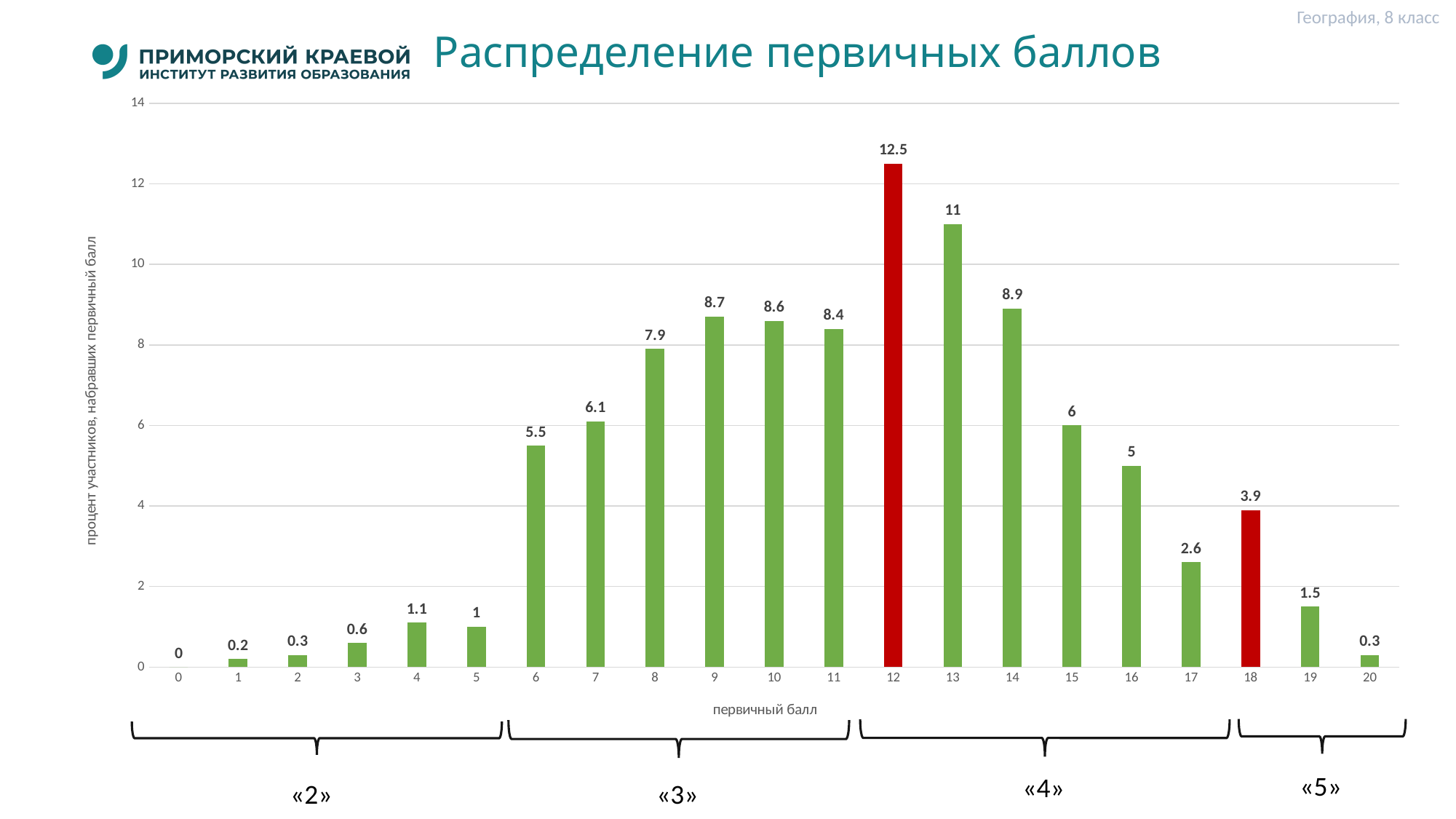
What is the title of the chart? Распределение первичных баллов How many primary score categories are shown on the x axis? 21 Do the values rise or fall from primary score 13 to primary score 17? fall Which is larger, the value for primary score 9 or primary score 10? 9 What kind of chart is shown on the slide? bar chart What is the value for primary score 7? 6.1 Which primary score has the lowest percentage of participants? 0 What is the difference between the values for primary scores 12 and 13? 1.5 What is the value for primary score 12? 12.5 Which primary score has the highest percentage of participants? 12 What is the value for primary score 18? 3.9 Is the value for primary score 14 greater or less than 8? greater